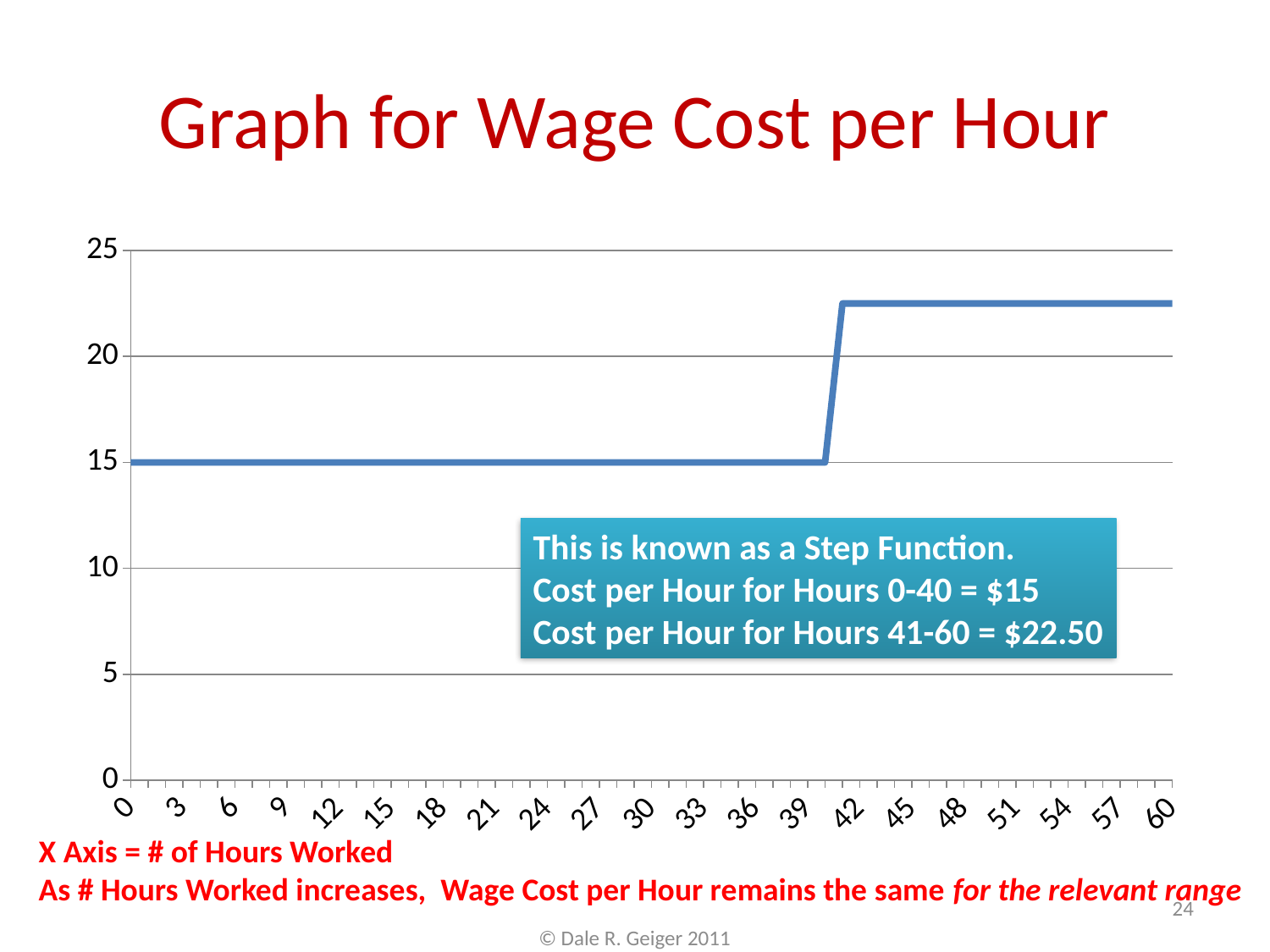
What is the wage cost per hour for hours 41-60? $22.50 Which is larger, the wage cost per hour at 20 hours worked or at 50 hours worked? 50 hours worked What is the title of the chart on the slide? Graph for Wage Cost per Hour What type of function does the slide say the chart represents? Step Function What kind of chart is shown on the slide? line chart What is the wage cost per hour for hours 0-40? $15 Does the wage cost per hour rise, fall, or stay the same as hours worked increase from 0 to 40? stays the same What does the x axis of the chart represent? # of Hours Worked Is the wage cost per hour at 30 hours worked greater or less than 20? less What is the difference between the wage cost per hour for hours 41-60 and for hours 0-40? $7.50 Is the wage cost per hour at 50 hours worked greater or less than 20? greater